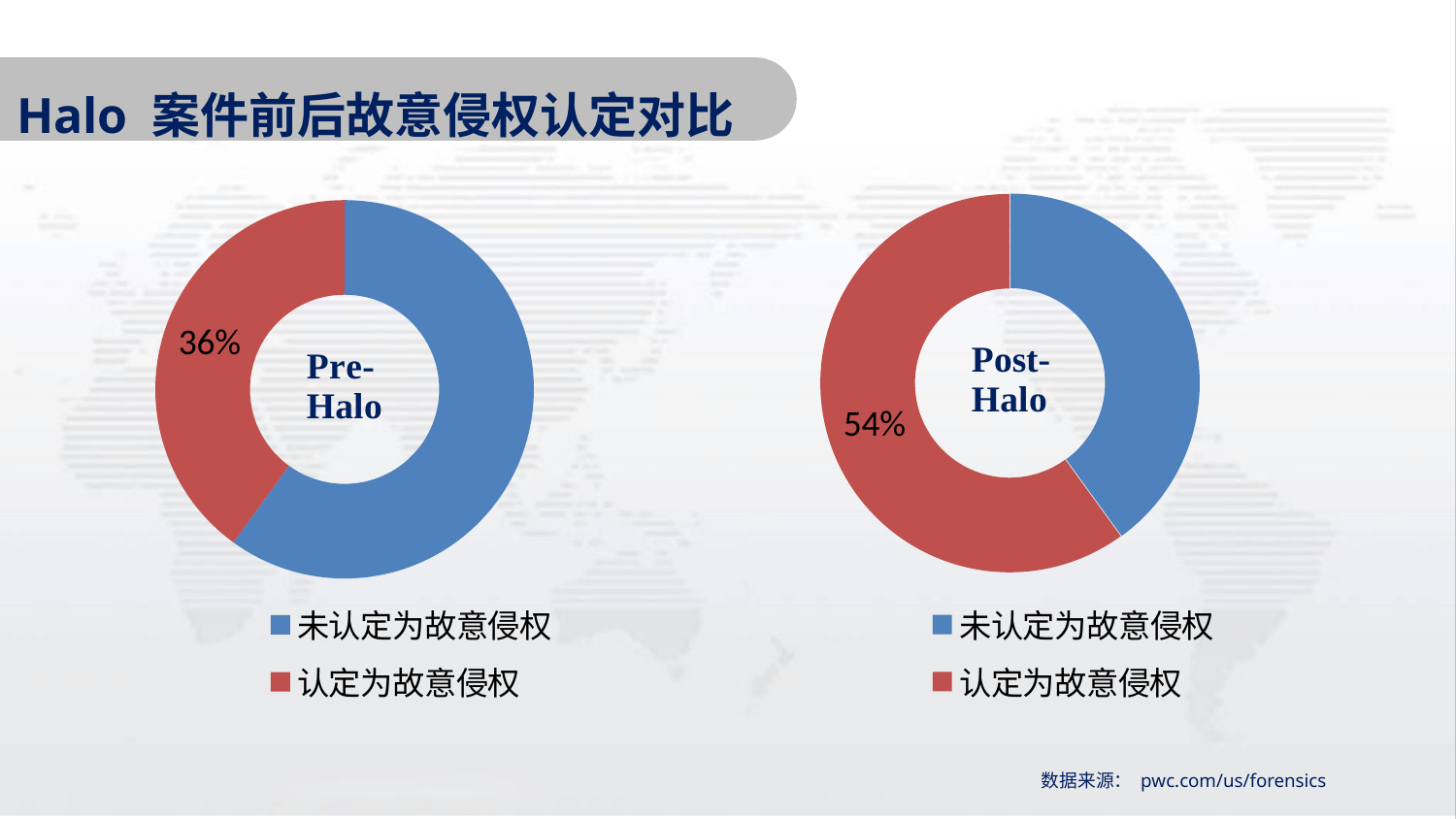
What share of the Pre-Halo chart is taken by the 认定为故意侵权 slice? 36% How many categories does the legend of the Post-Halo chart list? 2 What kind of chart is the Pre-Halo chart? Doughnut (pie) chart What colour represents 认定为故意侵权 in the legends of both charts? Red By how many percentage points does the labelled 认定为故意侵权 share in the Post-Halo chart exceed that in the Pre-Halo chart? 18 percentage points How many slices does the Pre-Halo chart have? 2 What is the title of the slide containing the two charts? Halo 案件前后故意侵权认定对比 In the Post-Halo chart, which slice is larger: 未认定为故意侵权 or 认定为故意侵权? 认定为故意侵权 In the Pre-Halo chart, which slice is larger: 未认定为故意侵权 or 认定为故意侵权? 未认定为故意侵权 In the Pre-Halo chart, what percentage is labelled for 认定为故意侵权? 36% Which chart has the larger labelled share for 认定为故意侵权, Pre-Halo or Post-Halo? Post-Halo In the Post-Halo chart, what percentage is labelled for 认定为故意侵权? 54%